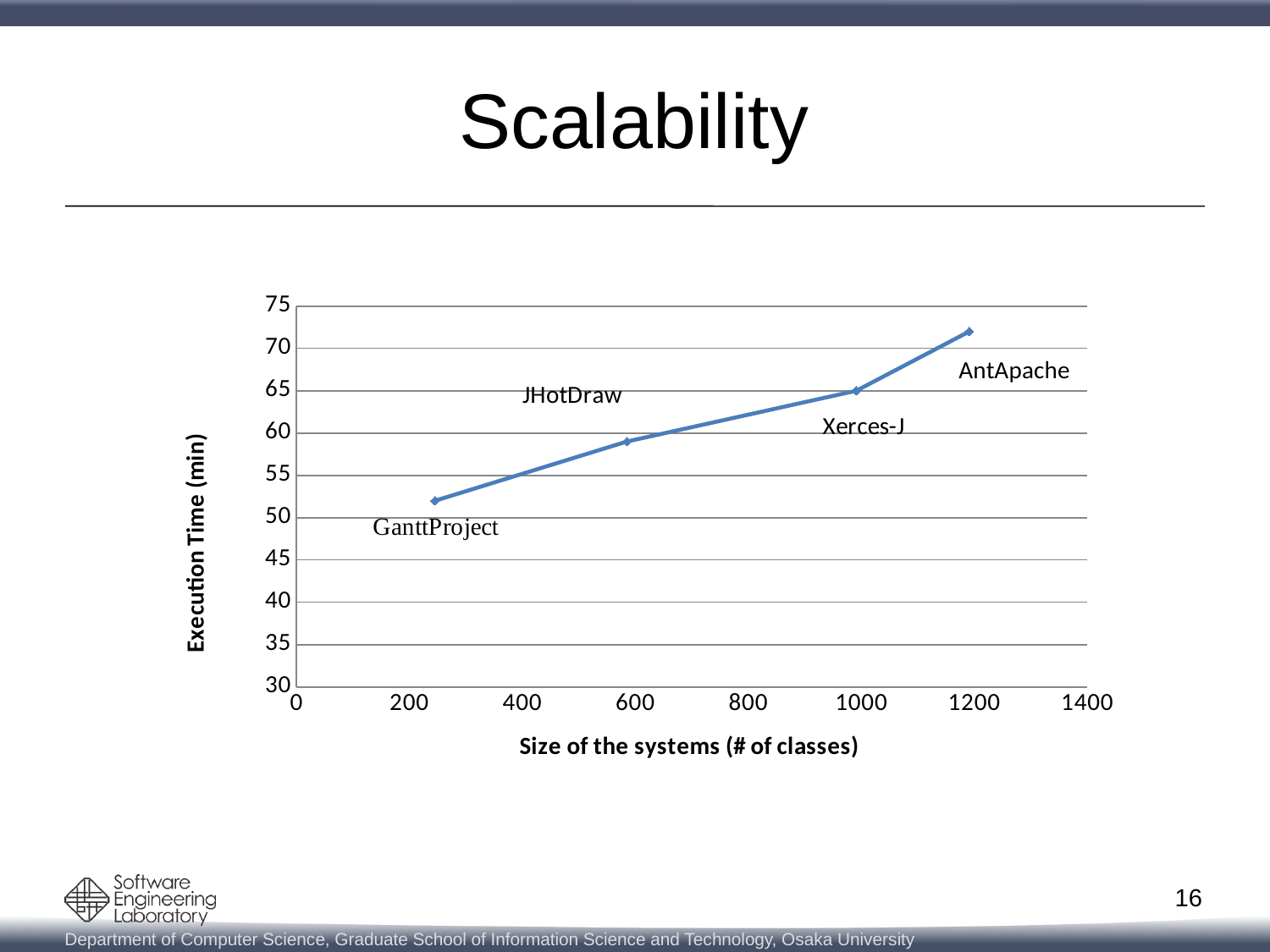
What is the label of the x axis? Size of the systems (# of classes) Does execution time rise or fall as the size of the systems increases? rise Is the execution time for GanttProject greater or less than 55 minutes? less Which has the larger execution time, Xerces-J or JHotDraw? Xerces-J Which system has the lowest execution time? GanttProject Is the execution time for AntApache greater or less than 70 minutes? greater What kind of chart is shown on the slide? line chart What is the label of the y axis? Execution Time (min) How many systems (data points) are plotted on the chart? 4 Is the execution time for JHotDraw greater or less than 55 minutes? greater Which system has the highest execution time? AntApache